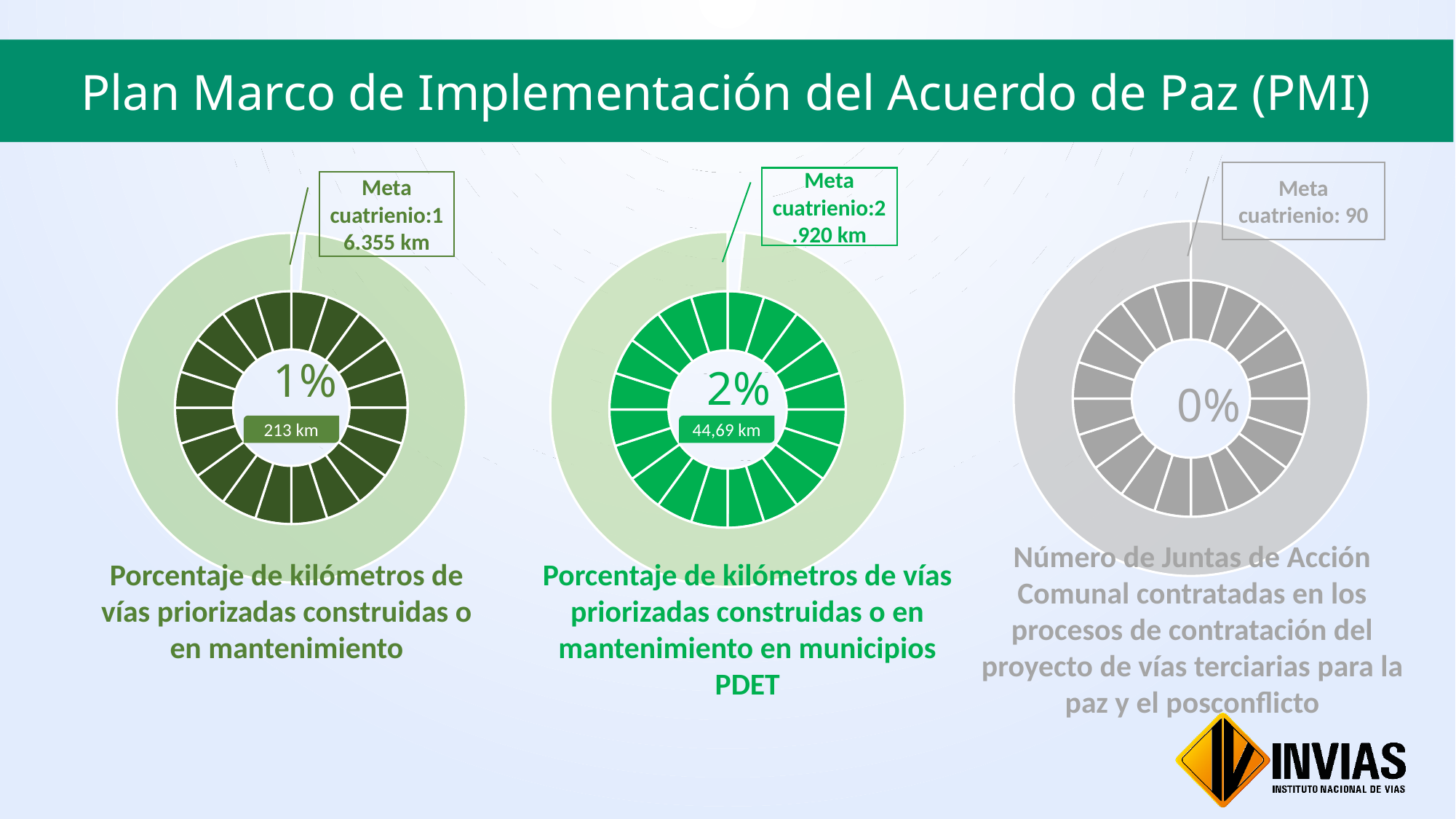
On the middle chart (vías priorizadas en municipios PDET), what percentage is shown in the centre? 2% On the left chart (Porcentaje de kilómetros de vías priorizadas construidas o en mantenimiento), what percentage is shown in the centre? 1% What kind of chart is used for each indicator on the slide? Donut (ring) chart How many charts are shown on the slide? 3 What is the 'Meta cuatrienio' value shown for the left chart? 16.355 km On the middle chart, how many kilometres are shown in the label below the percentage? 44,69 km What is the 'Meta cuatrienio' value shown for the right chart? 90 Which of the three charts shows the highest percentage? The middle chart (municipios PDET), 2% Which of the three charts shows the lowest percentage? The right chart (Juntas de Acción Comunal), 0% On the left chart, how many kilometres are shown in the label below the percentage? 213 km On the right chart (Número de Juntas de Acción Comunal contratadas), what percentage is shown in the centre? 0% What is the 'Meta cuatrienio' value shown for the middle chart? 2.920 km